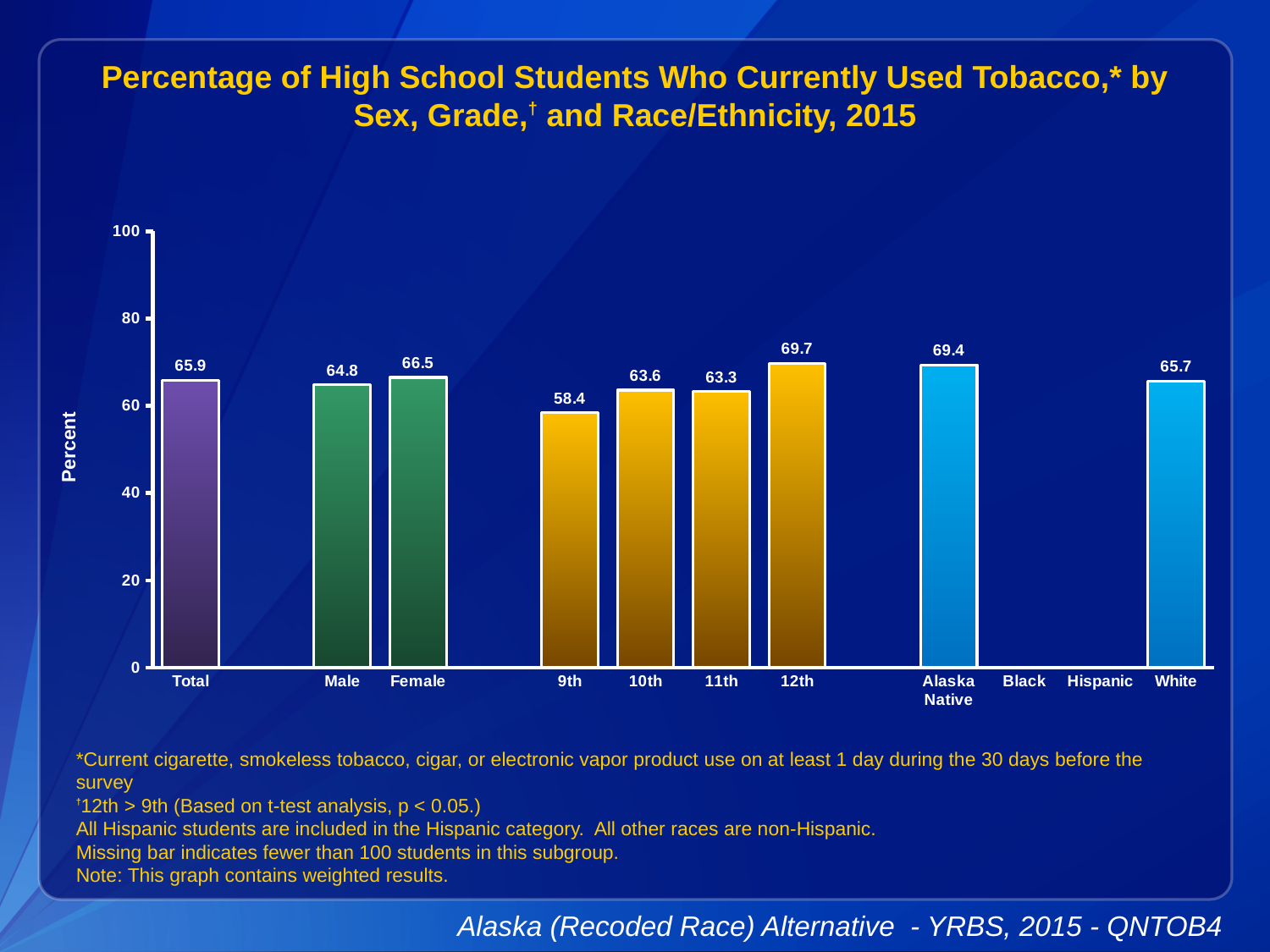
How many bars are plotted on the chart? 9 What is the difference between the Female and Male values? 1.7 What is the value for Total? 65.9 Which category has the highest value? 12th Which categories have no bar shown? Black and Hispanic What is the value for Alaska Native? 69.4 Which is larger, the value for 12th or the value for 9th? 12th What kind of chart is shown? bar chart Which category has the lowest value among the bars shown? 9th Is the value for White greater or less than 60? greater What is the value for 9th grade? 58.4 What is the label on the y axis? Percent